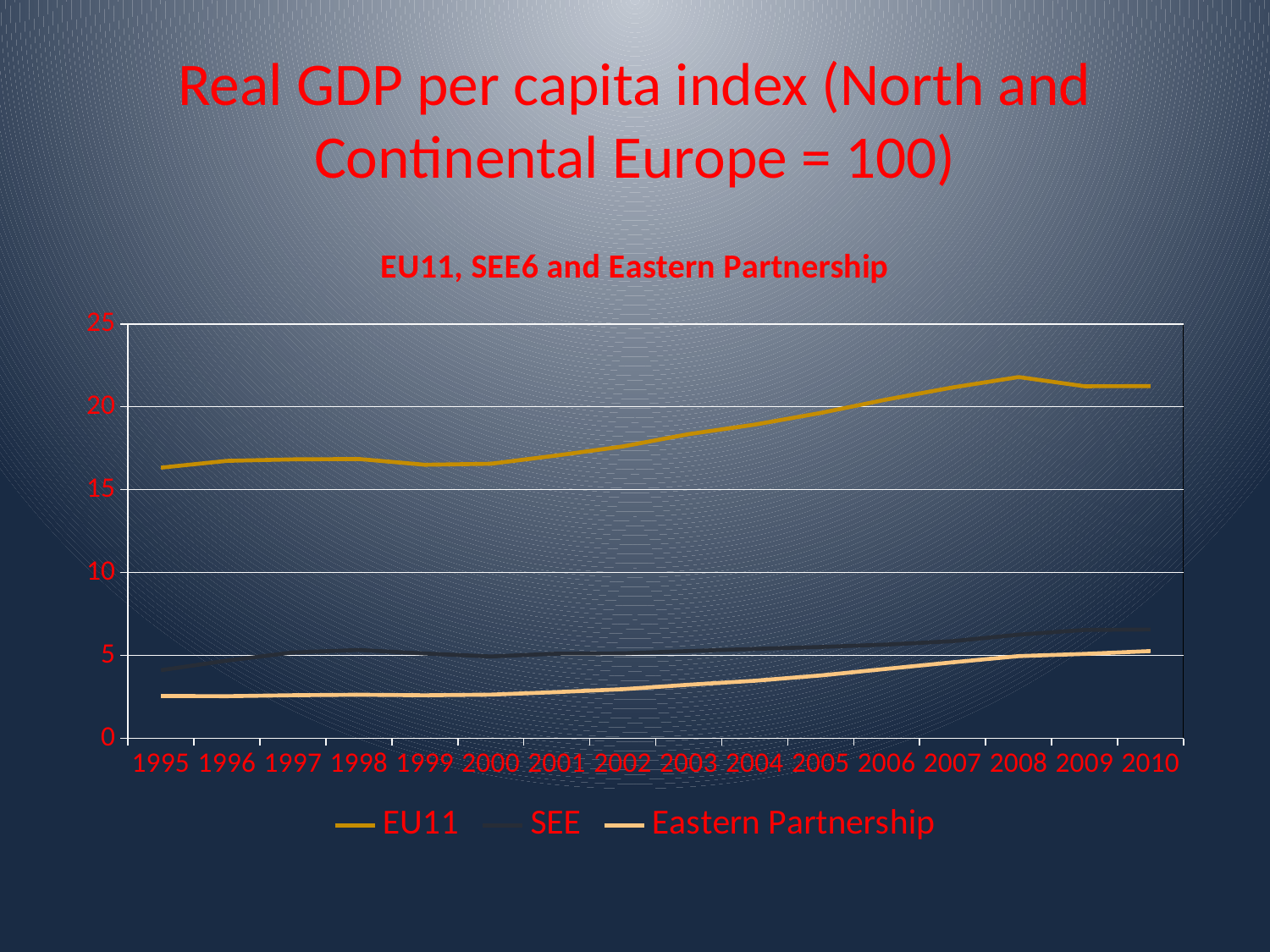
Which is larger in 1995, the value for SEE or the value for Eastern Partnership? SEE Is the value for SEE in 1995 greater or less than 5? less Which series has the lowest value in 1995? Eastern Partnership How many series does the legend list? 3 Is the value for SEE in 2010 greater or less than 5? greater Is the value for EU11 in 1995 greater or less than 15? greater How many years are shown along the x axis? 16 What is the title shown directly above the chart? EU11, SEE6 and Eastern Partnership What kind of chart is shown on the slide? line chart Does the EU11 series rise or fall between 1995 and 2008? rise Which series has the highest value in 2010? EU11